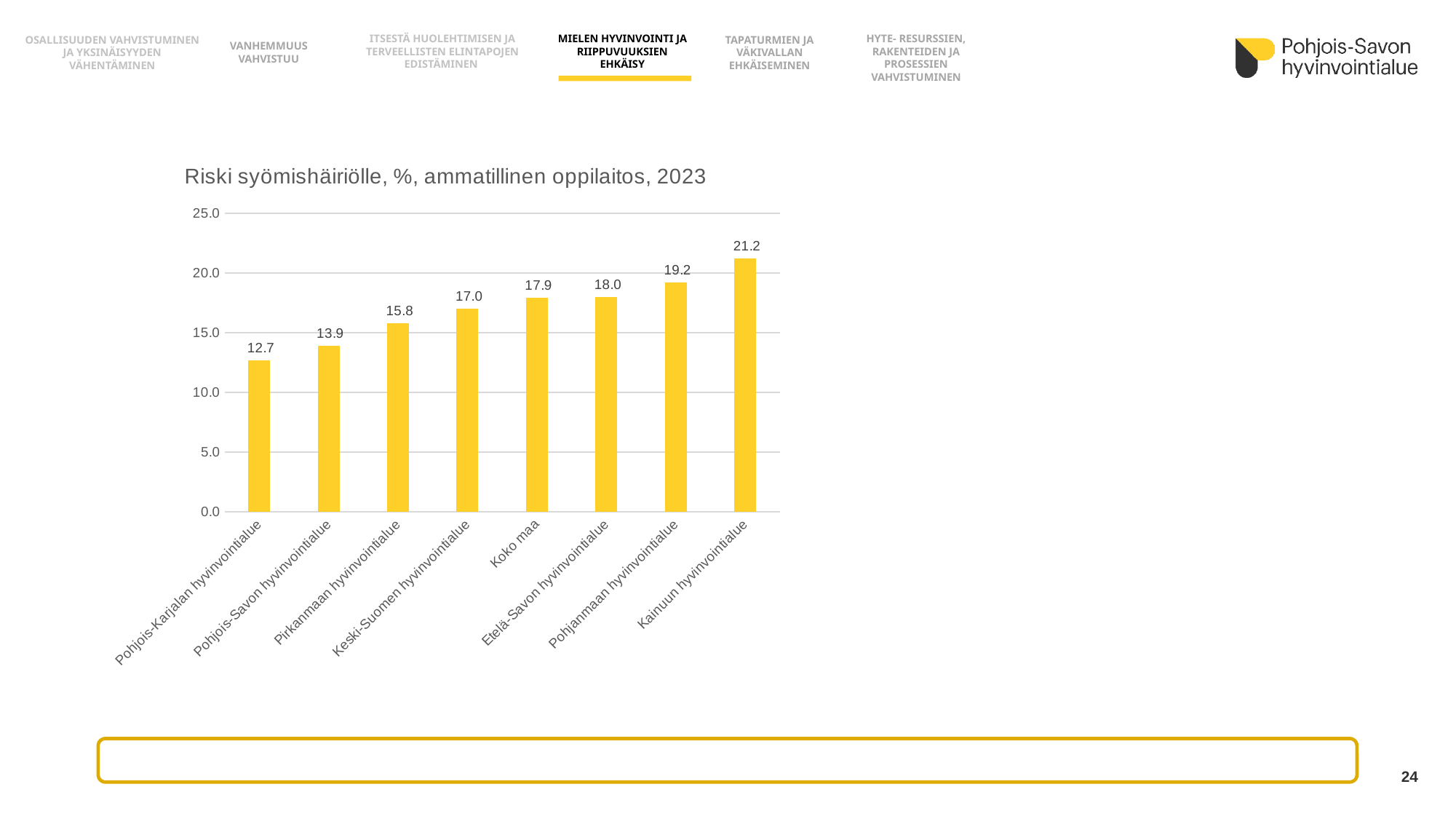
What is the value for Koko maa? 17.9 What kind of chart is shown on the slide? bar chart Which category has the highest value? Kainuun hyvinvointialue How many categories are shown on the chart? 8 Which is larger, the value for Pirkanmaan hyvinvointialue or the value for Etelä-Savon hyvinvointialue? Etelä-Savon hyvinvointialue Is the value for Pohjanmaan hyvinvointialue greater or less than 20.0? less What is the value for Kainuun hyvinvointialue? 21.2 What is the difference between the values for Koko maa and Pohjois-Savon hyvinvointialue? 4.0 What is the difference between the values for Kainuun hyvinvointialue and Pohjois-Karjalan hyvinvointialue? 8.5 What is the value for Pohjois-Savon hyvinvointialue? 13.9 Which category has the lowest value? Pohjois-Karjalan hyvinvointialue What is the title of the chart? Riski syömishäiriölle, %, ammatillinen oppilaitos, 2023